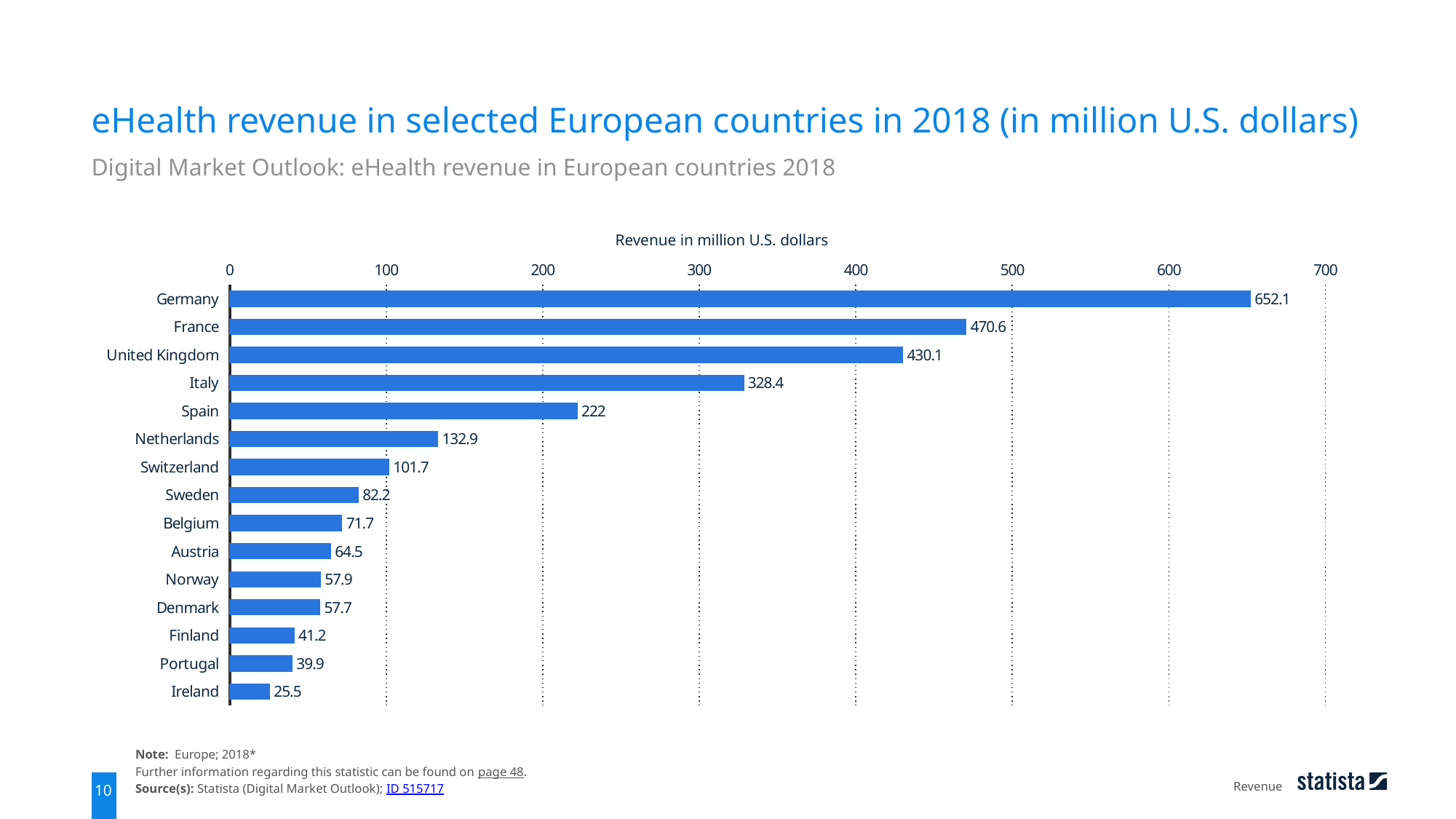
What kind of chart is shown on the slide? Bar chart What is the label of the horizontal axis? Revenue in million U.S. dollars What is the eHealth revenue for Switzerland? 101.7 What is the eHealth revenue for Germany in 2018? 652.1 Which country has the lowest eHealth revenue? Ireland Is the value for Italy greater or less than 300? greater What is the difference in eHealth revenue between France and the United Kingdom? 40.5 What is the difference in eHealth revenue between Germany and Italy? 323.7 What is the eHealth revenue for Spain? 222 Which country has the highest eHealth revenue? Germany How many countries are shown in the chart? 15 Which has a higher eHealth revenue, the Netherlands or Sweden? Netherlands